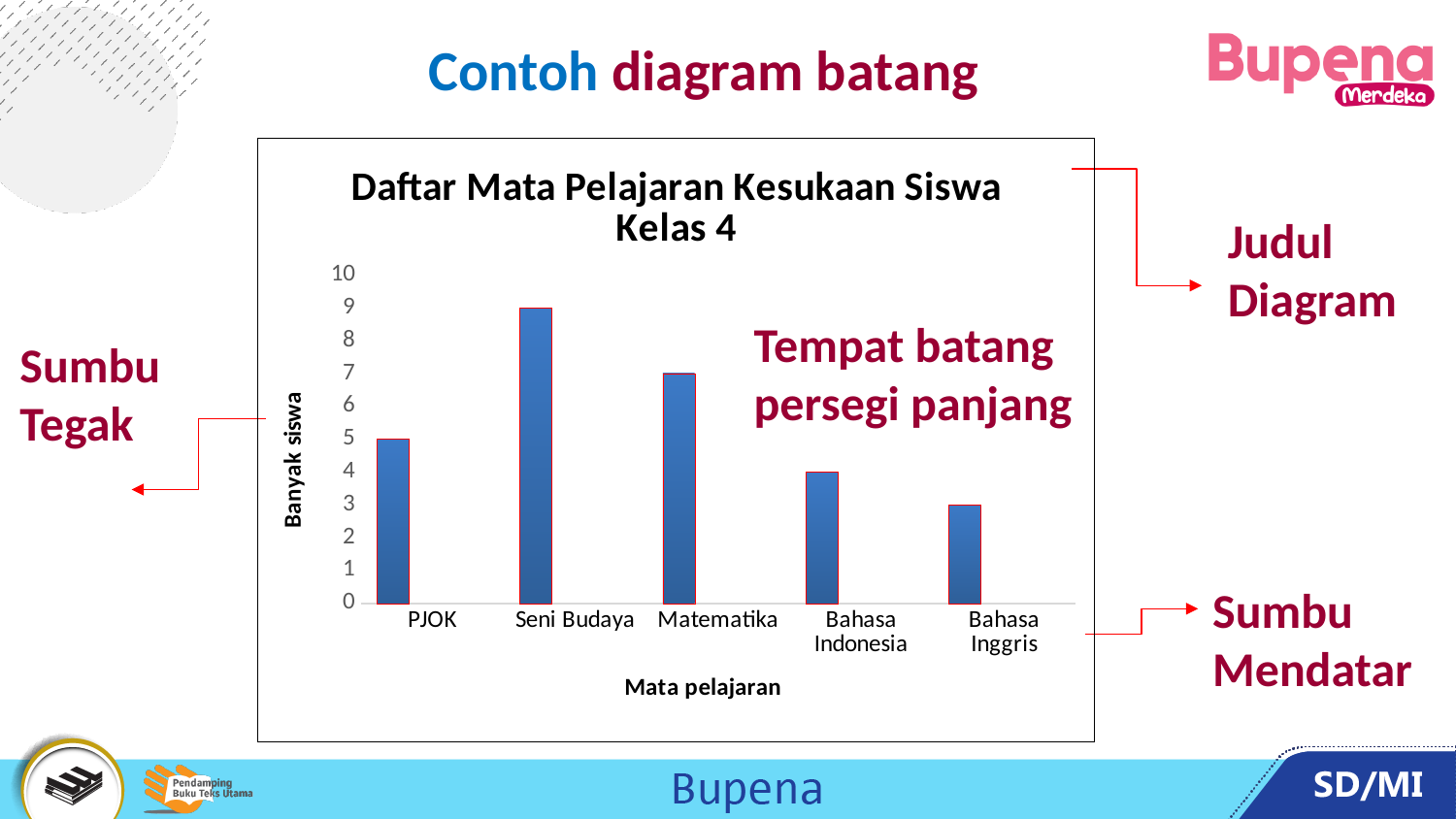
What is the label of the vertical axis of the chart? Banyak siswa Which subject has the lowest number of students? Bahasa Inggris How many subjects (categories) are shown on the x axis of the chart? 5 How many students chose Matematika? 7 Which has more students, Matematika or Bahasa Indonesia? Matematika How many students chose PJOK? 5 Is the value for Bahasa Indonesia greater or less than 5? less How many students chose Seni Budaya? 9 What type of chart is shown on the slide? bar chart Which subject has the highest number of students? Seni Budaya What is the title of the chart? Daftar Mata Pelajaran Kesukaan Siswa Kelas 4 What is the difference between the number of students for Seni Budaya and Bahasa Inggris? 6